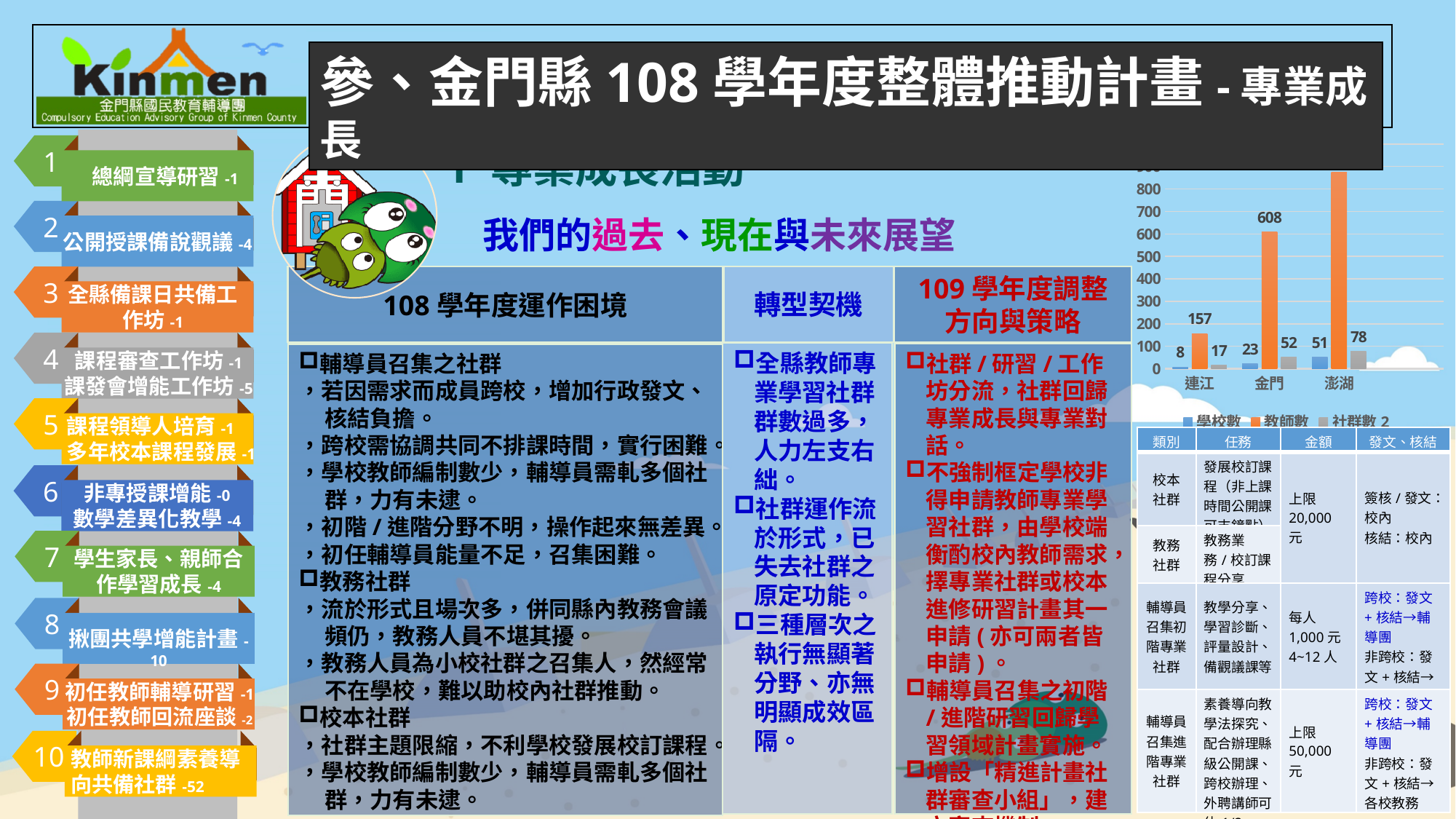
In the bar chart, what is the 社群數 2 value for 澎湖? 78 What type of chart is shown on the right side of the slide? bar chart How many series does the legend of the bar chart list? 3 In the bar chart, which category has the lowest 社群數 2? 連江 In the bar chart, what is the difference between the 社群數 2 values for 金門 and 連江? 35 In the bar chart, what is the 教師數 value for 金門? 608 In the bar chart, what is the 教師數 value for 連江? 157 In the bar chart, what is the 學校數 value for 連江? 8 In the bar chart, what is the 學校數 value for 澎湖? 51 How many categories are shown on the x axis of the bar chart? 3 In the bar chart, is the 教師數 value for 澎湖 greater or less than 800? greater In the bar chart, which category has the highest 學校數? 澎湖